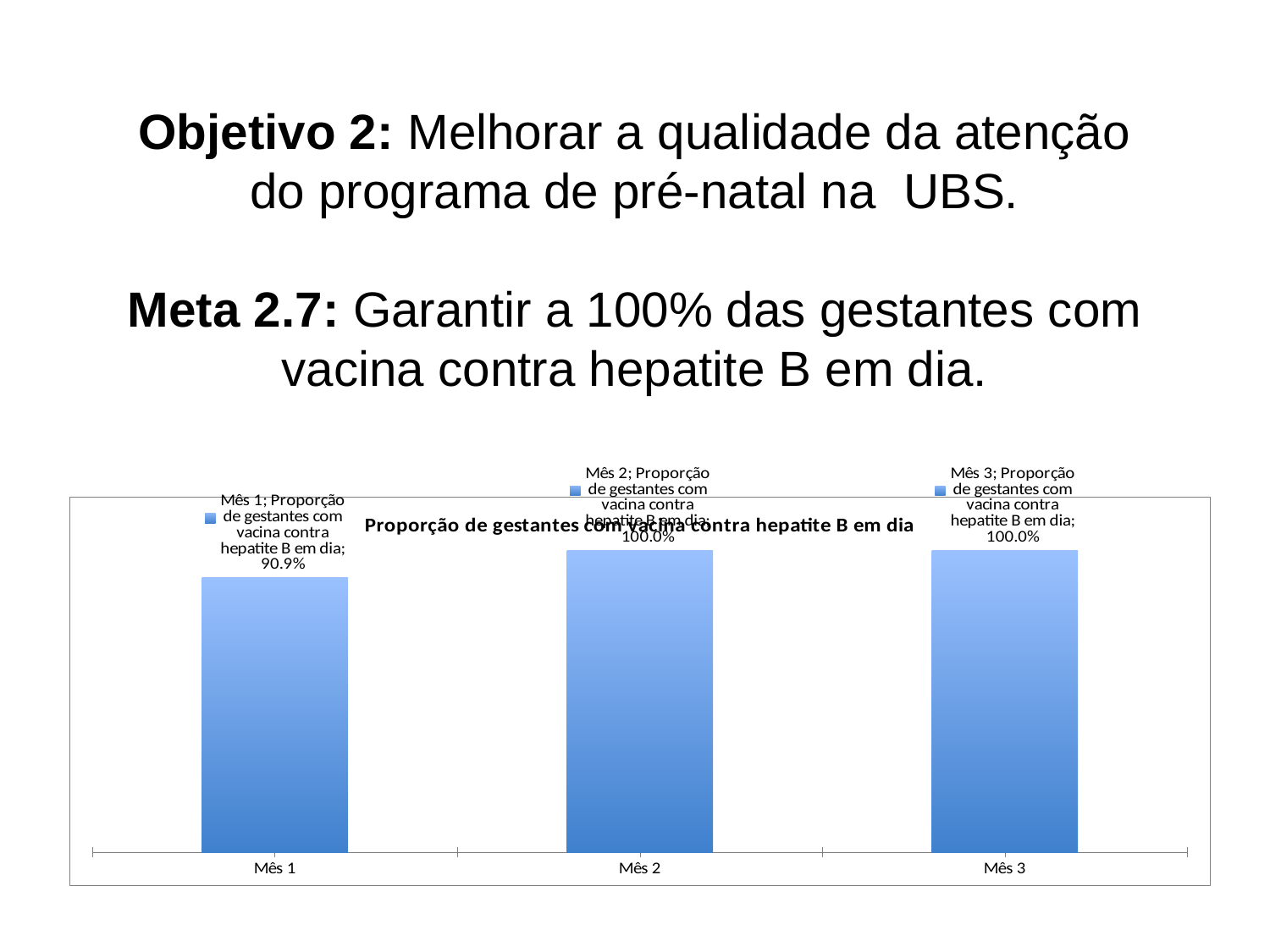
What is the title of the chart? Proporção de gestantes com vacina contra hepatite B em dia Does the value rise or fall from Mês 1 to Mês 2? Rise Which is larger, the value for Mês 1 or the value for Mês 3? Mês 3 Do the values for Mês 2 and Mês 3 differ? No, both are 100.0% How many months (categories) are shown in the chart? 3 What is the value for Mês 3 in the chart? 100.0% What kind of chart is shown on the slide? Bar chart Which month has the lowest proportion of pregnant women with hepatitis B vaccine up to date? Mês 1 What is the value for Mês 2 in the chart? 100.0% How many data series does the chart plot? 1 What is the difference between the values for Mês 2 and Mês 1? 9.1 percentage points What is the value for Mês 1 in the chart? 90.9%